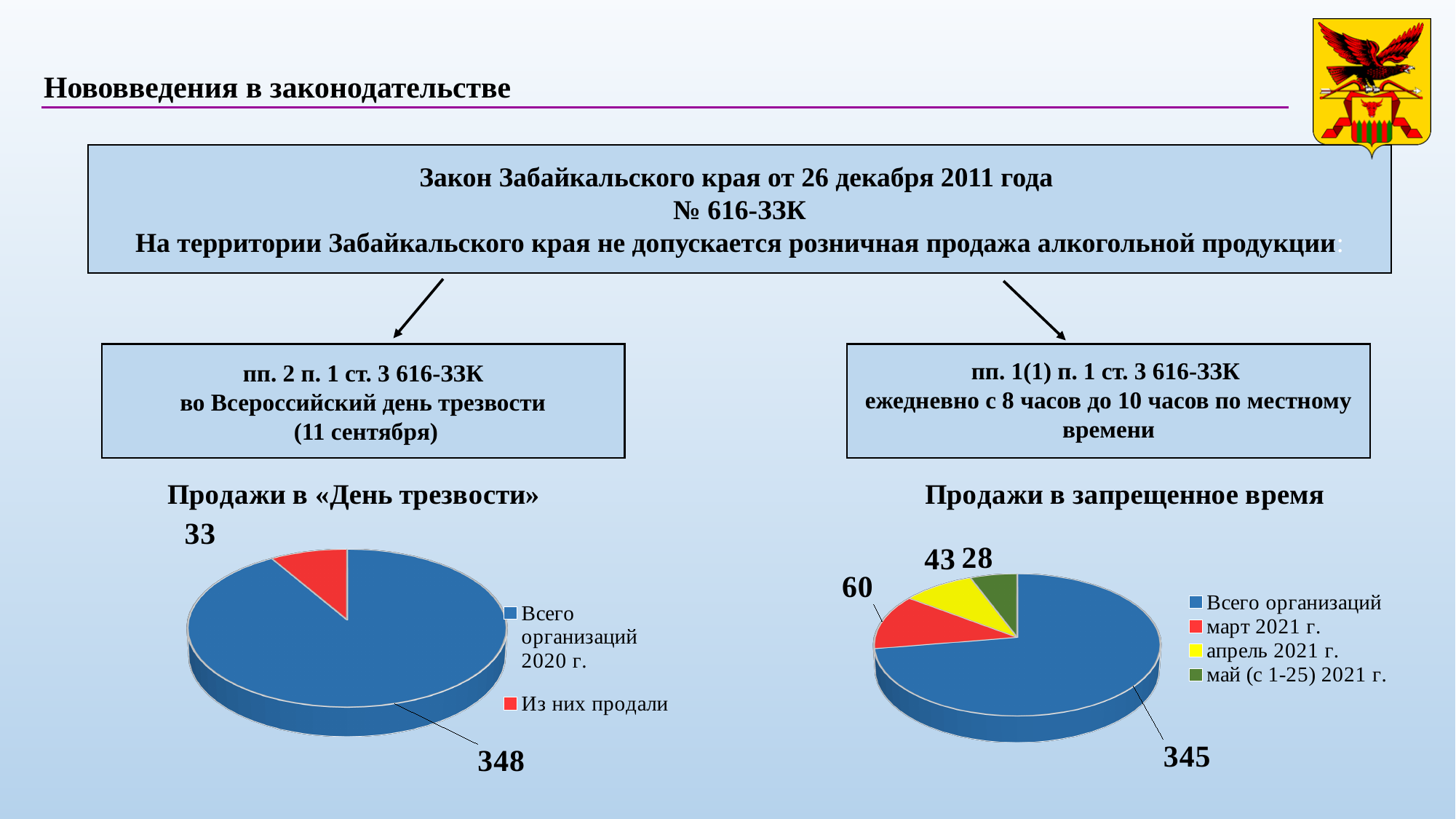
In the chart titled «Продажи в запрещенное время», which category has the smallest slice? май (с 1-25) 2021 г. In the chart titled «Продажи в «День трезвости»», what is the difference between «Всего организаций 2020 г.» and «Из них продали»? 315 In the chart titled «Продажи в «День трезвости»», what is the value for «Из них продали»? 33 How many categories does the legend of the chart titled «Продажи в запрещенное время» list? 4 In the chart titled «Продажи в запрещенное время», what is the difference between «март 2021 г.» and «май (с 1-25) 2021 г.»? 32 In the chart titled «Продажи в запрещенное время», what is the value for «Всего организаций»? 345 In the chart titled «Продажи в запрещенное время», what is the value for «май (с 1-25) 2021 г.»? 28 What type of chart is the chart titled «Продажи в «День трезвости»»? Pie chart In the chart titled «Продажи в запрещенное время», which category has the largest slice? Всего организаций In the chart titled «Продажи в запрещенное время», what is the value for «март 2021 г.»? 60 In the chart titled «Продажи в запрещенное время», which is larger: «апрель 2021 г.» or «март 2021 г.»? март 2021 г. In the chart titled «Продажи в «День трезвости»», what is the value for «Всего организаций 2020 г.»? 348